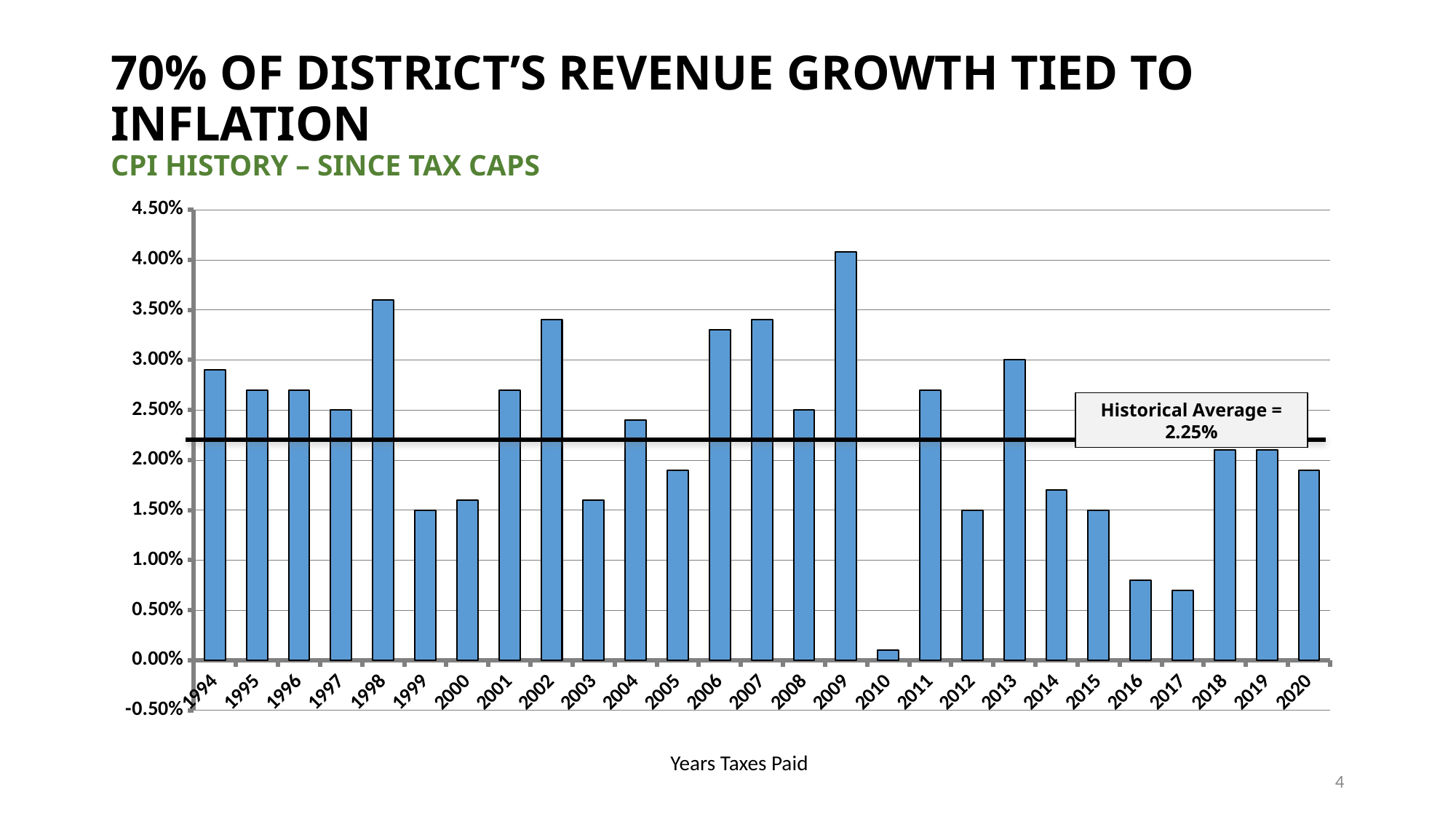
How many years are plotted along the x axis of the chart? 27 What historical average is labelled on the horizontal line in the chart? 2.25% Is the value for 2017 greater or less than 1.00%? less Which year has the highest CPI value in the chart? 2009 What is the title of the x axis of the chart? Years Taxes Paid Is the value for 2009 greater or less than 4.00%? greater Which year has the lowest CPI value in the chart? 2010 Is the value for 2010 greater or less than 0.50%? less Which year has the larger value, 2006 or 2005? 2006 What kind of chart is shown on the slide? bar chart Which year has the larger value, 2009 or 1998? 2009